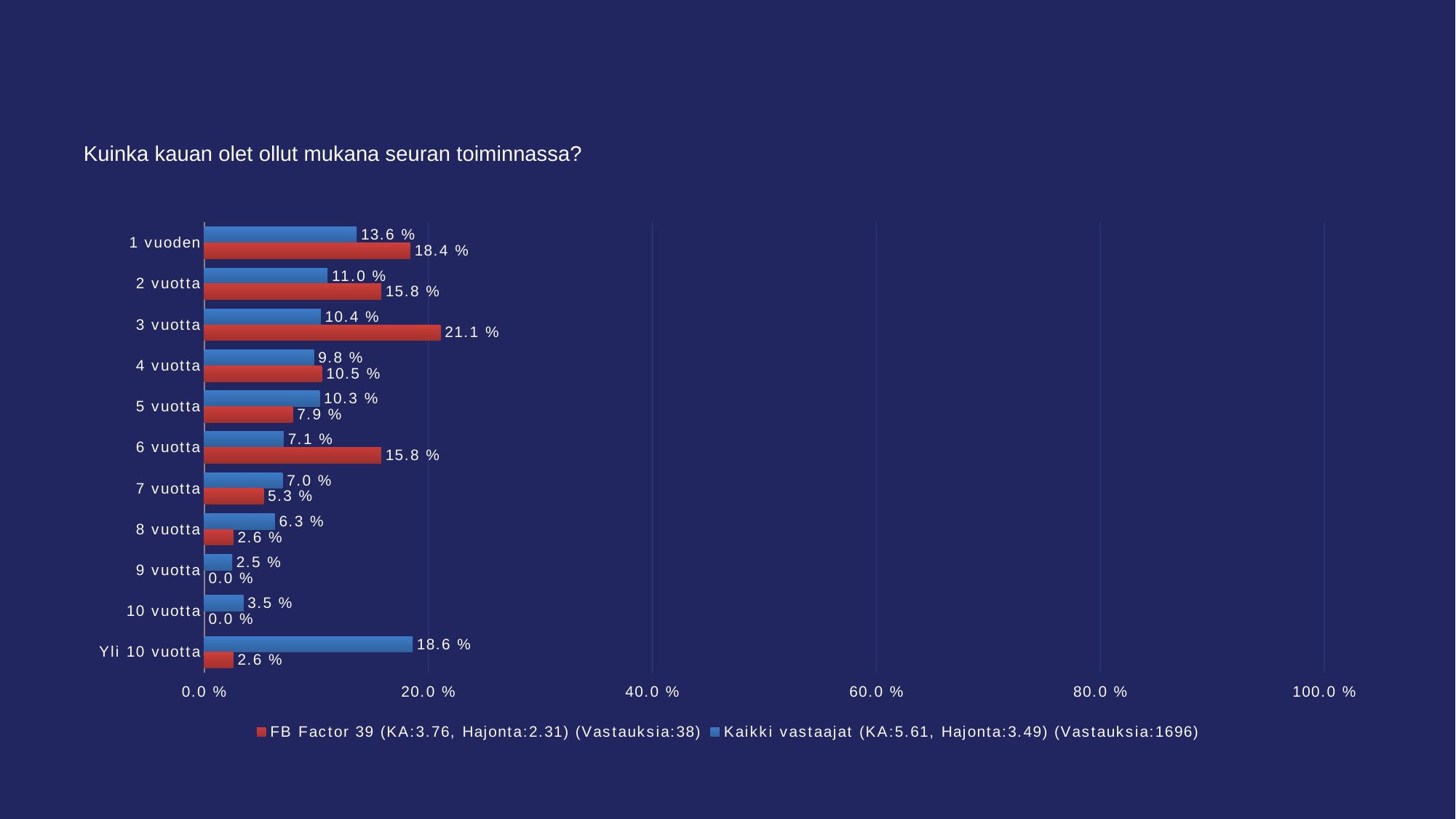
What is the value for Kaikki vastaajat in the 5 vuotta category? 10.3 % Which category has the highest value for Kaikki vastaajat? Yli 10 vuotta What is the difference between FB Factor 39 and Kaikki vastaajat in the 3 vuotta category? 10.7 % What is the value for FB Factor 39 in the 9 vuotta category? 0.0 % How many categories are shown on the chart? 11 Which category has the lowest value for Kaikki vastaajat? 9 vuotta In the 6 vuotta category, which series has the larger value, FB Factor 39 or Kaikki vastaajat? FB Factor 39 What is the value for Kaikki vastaajat in the Yli 10 vuotta category? 18.6 % How many series does the legend list? 2 Which category has the highest value for FB Factor 39? 3 vuotta What kind of chart is shown on the slide? bar chart What is the value for FB Factor 39 in the 3 vuotta category? 21.1 %